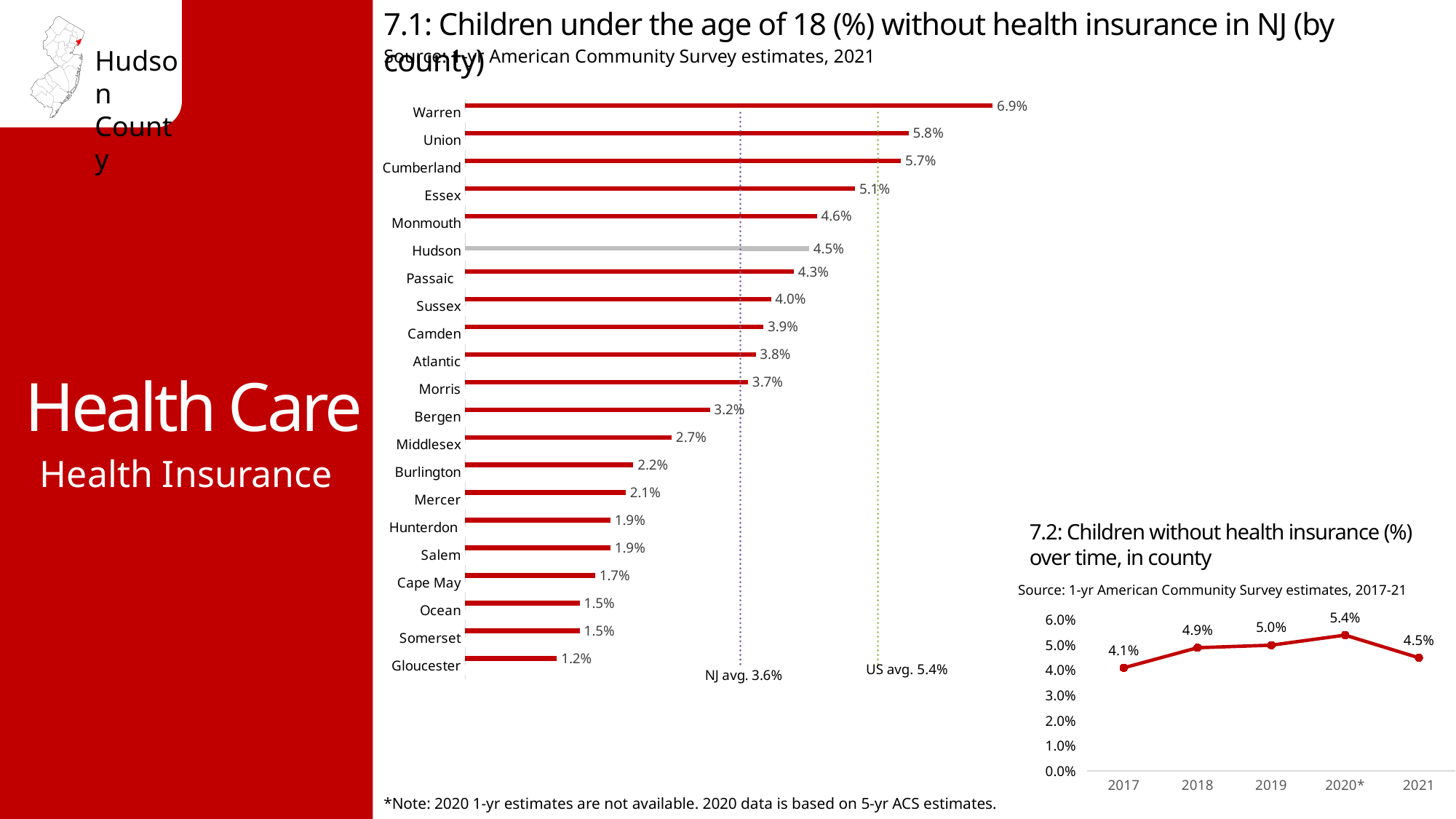
In chart 7.2, which year has the lowest value? 2017 In chart 7.1 (children without health insurance by county), what is the value for Hudson? 4.5% In chart 7.1, how many counties are plotted? 21 In chart 7.1, which is larger, the value for Essex or the value for Monmouth? Essex In chart 7.1, which county has the highest percentage of children without health insurance? Warren In chart 7.1, what is the value for Bergen? 3.2% In chart 7.2, what is the difference between the values for 2020* and 2021? 0.9% What kind of chart is chart 7.2 (children without health insurance over time)? Line chart In chart 7.1, what is the NJ average shown by the dotted reference line? 3.6% In chart 7.1, which county has the lowest percentage of children without health insurance? Gloucester In chart 7.1, what is the difference between the values for Warren and Gloucester? 5.7% In chart 7.2, what is the value for 2020*? 5.4%